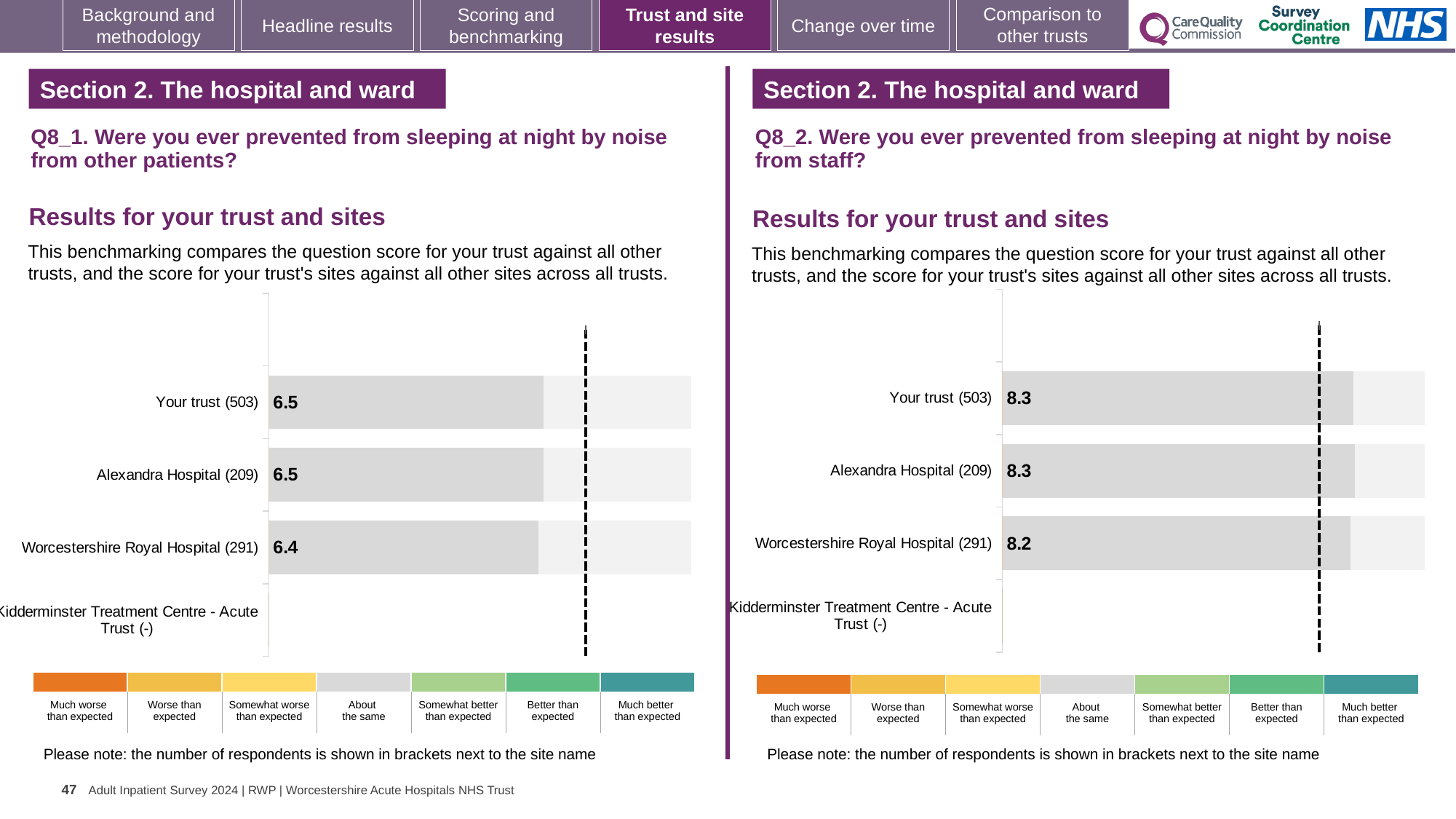
Which is larger: the Your trust score in the Q8_1 chart (noise from other patients) or the Your trust score in the Q8_2 chart (noise from staff)? Q8_2 (noise from staff) In the Q8_1 chart (noise from other patients), what is the score for Worcestershire Royal Hospital (291)? 6.4 How many categories (rows) are listed on the y axis of the Q8_1 chart (noise from other patients)? 4 In the Q8_1 chart (noise from other patients), what score is shown for Kidderminster Treatment Centre - Acute Trust? No score shown (-) In the Q8_2 chart (noise from staff), which site with a plotted score has the lowest value? Worcestershire Royal Hospital (291) In the Q8_2 chart (noise from staff), what is the score for Alexandra Hospital (209)? 8.3 How many benchmark categories are shown in the colour key below the Q8_1 chart (noise from other patients)? 7 In the Q8_2 chart (noise from staff), what is the score for Worcestershire Royal Hospital (291)? 8.2 In the Q8_2 chart (noise from staff), what is the difference between the scores for Your trust (503) and Worcestershire Royal Hospital (291)? 0.1 In the Q8_1 chart (noise from other patients), which site with a plotted score has the lowest value? Worcestershire Royal Hospital (291) What type of chart is used for the Q8_2 results (noise from staff)? Bar chart In the Q8_1 chart (noise from other patients), what is the score for Your trust (503)? 6.5